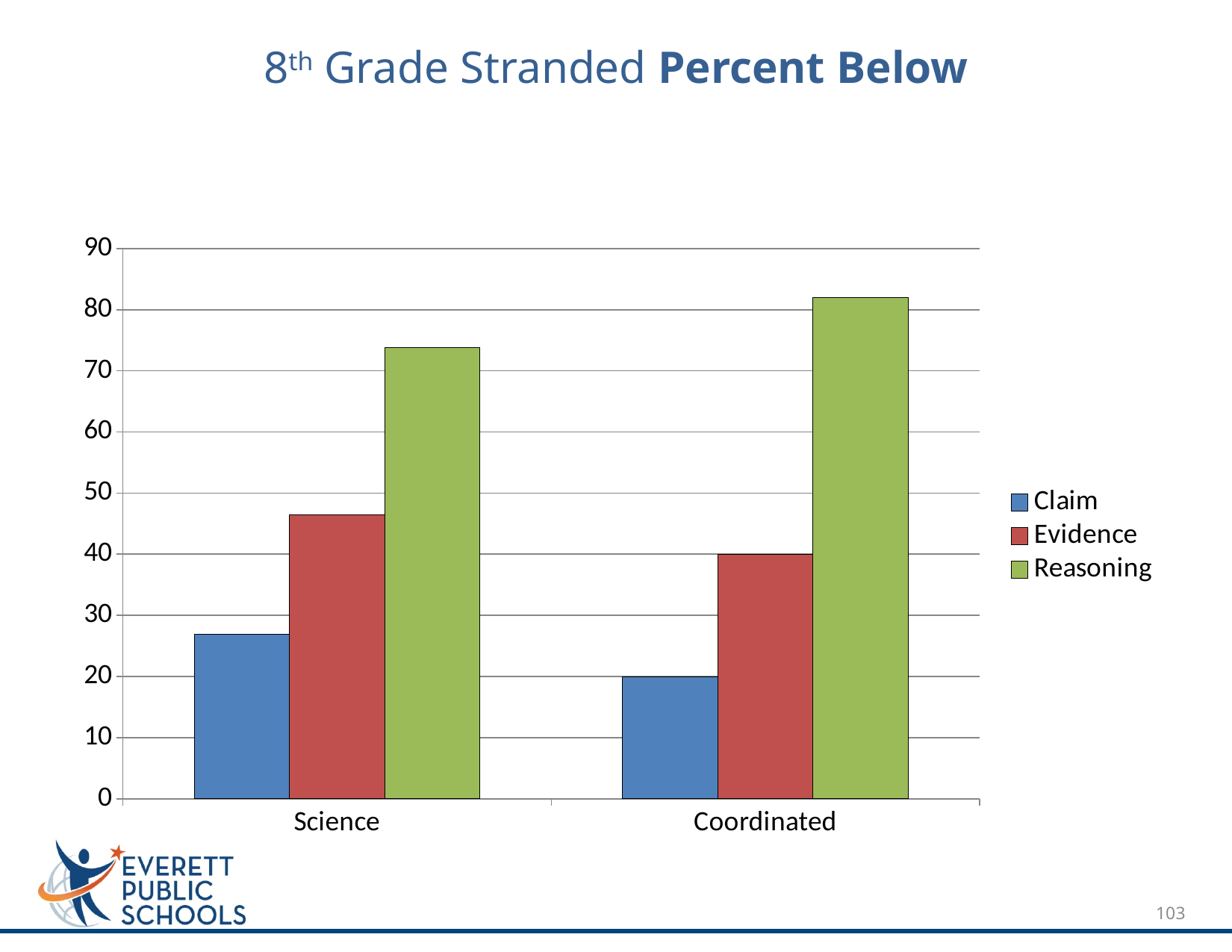
Which is larger, the Claim value for Science or the Claim value for Coordinated? Science Is the Reasoning value for Coordinated greater or less than 80? greater Which series has the lowest value for Coordinated? Claim Which series has the highest value for Science? Reasoning Is the Reasoning value for Science greater or less than 70? greater How many categories are shown on the x axis? 2 Is the Claim value for Science greater or less than 30? less What is the title of the chart? 8th Grade Stranded Percent Below Which is larger, the Reasoning value for Science or the Reasoning value for Coordinated? Coordinated What kind of chart is shown on the slide? bar chart How many series does the legend list? 3